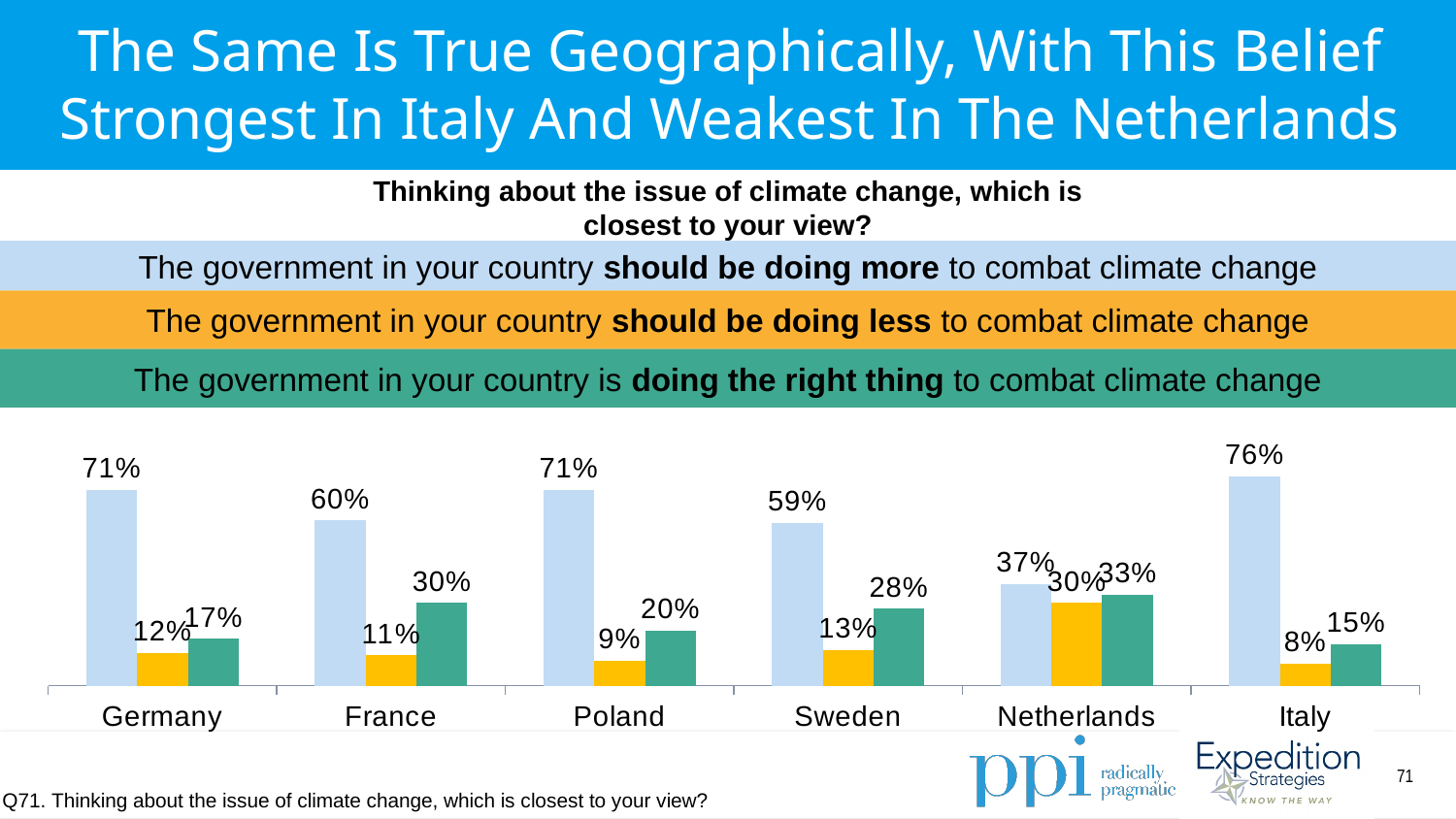
What percentage of respondents in France say the government is doing the right thing to combat climate change? 30% Which country has the highest share saying the government should be doing more? Italy What is the difference between the 'should be doing more' values for Italy and the Netherlands? 39 percentage points What percentage of respondents in the Netherlands say the government should be doing less to combat climate change? 30% Which country has the lowest share saying the government should be doing less? Italy Which colour represents the 'should be doing less' response? Orange Which country has the lowest share saying the government should be doing more? Netherlands How many series does the chart show? 3 Which is larger: the 'doing the right thing' value for Sweden or for Poland? Sweden How many countries are shown on the chart? 6 What type of chart is shown on the slide? Bar chart What percentage of respondents in Italy say the government should be doing more to combat climate change? 76%